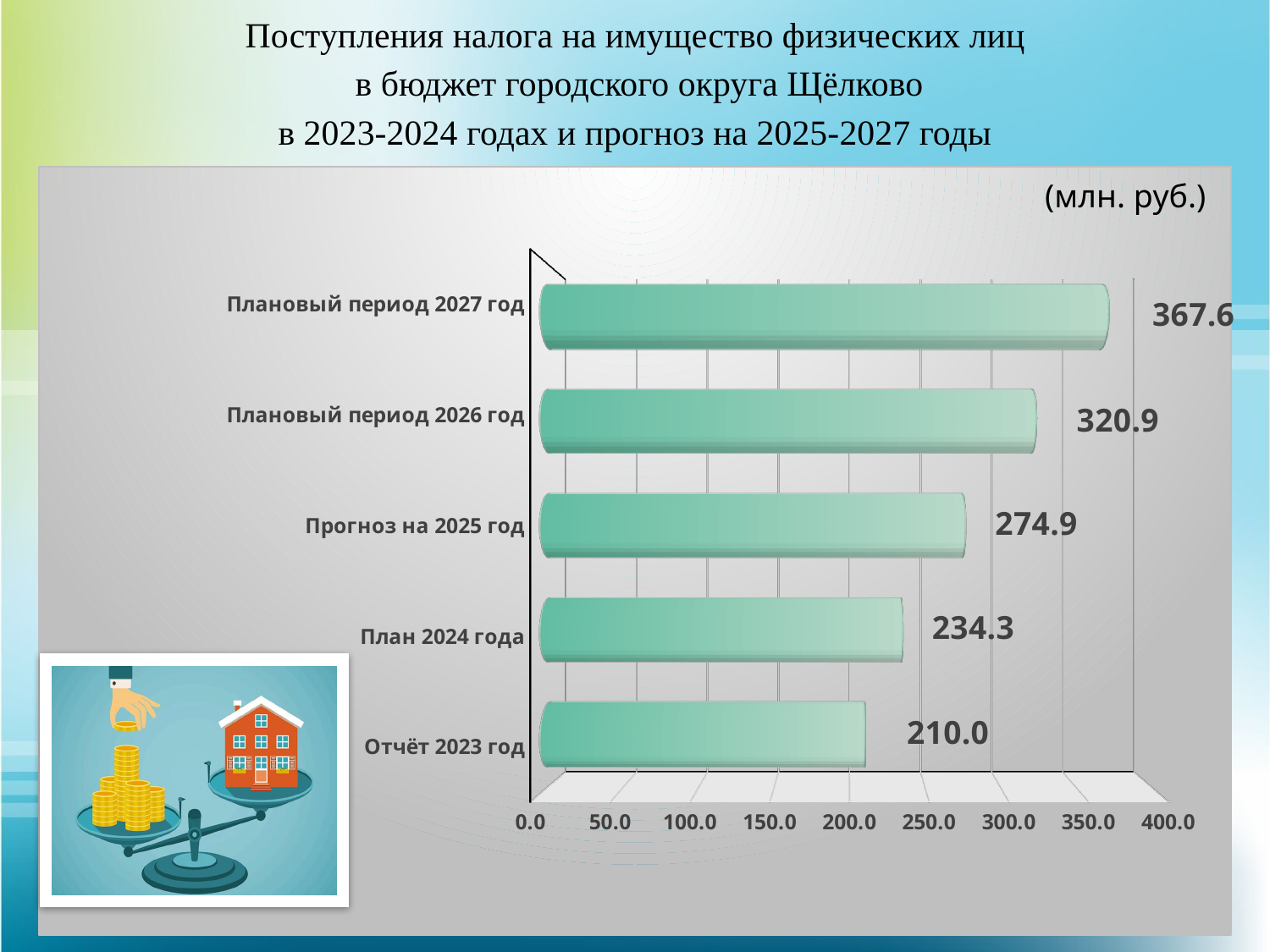
Which category has the lowest value? Отчёт 2023 год What unit is indicated for the values in the chart? млн. руб. What is the value for Плановый период 2026 год? 320.9 What kind of chart is shown on the slide? Bar chart What is the difference between the values for Плановый период 2027 год and Отчёт 2023 год? 157.6 Which category has the highest value? Плановый период 2027 год What is the value for План 2024 года? 234.3 What is the value for Отчёт 2023 год? 210.0 Which is larger, the value for План 2024 года or the value for Прогноз на 2025 год? Прогноз на 2025 год What is the difference between the values for Плановый период 2026 год and Прогноз на 2025 год? 46.0 How many categories are shown in the chart? 5 What is the value for Прогноз на 2025 год? 274.9